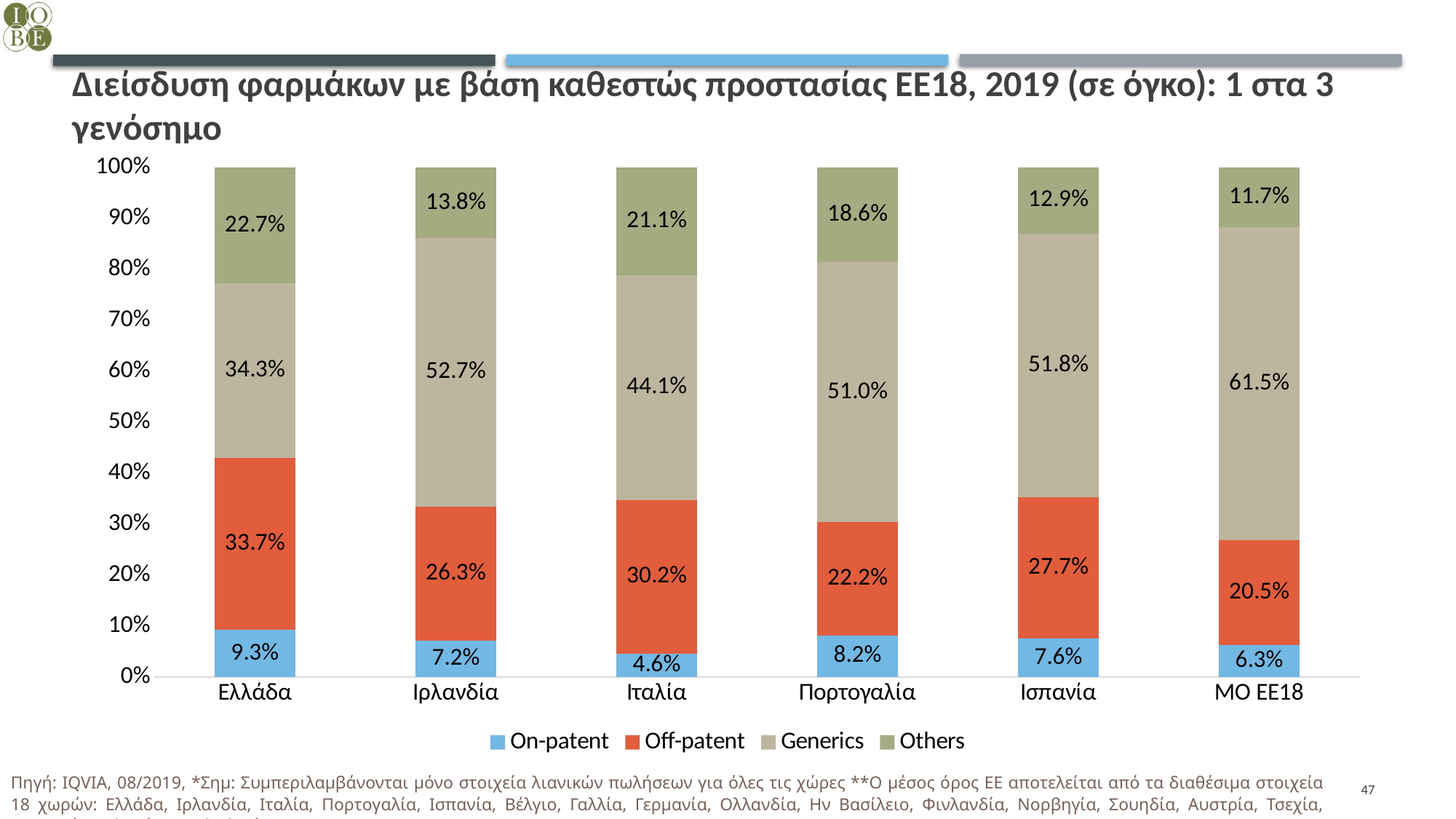
What is the Off-patent share for ΜΟ ΕΕ18? 20.5% How many categories are shown on the x axis? 6 Which is larger: the Others share for Ιρλανδία or for Ιταλία? Ιταλία What kind of chart is shown on the slide? Stacked bar chart What is the difference in Generics share between ΜΟ ΕΕ18 and Ελλάδα? 27.2 percentage points Which category has the highest Generics share? ΜΟ ΕΕ18 What is the Others share for Πορτογαλία? 18.6% Which category has the lowest On-patent share? Ιταλία How many series does the legend list? 4 What is the On-patent share for Ιταλία? 4.6% Which category has the highest Off-patent share? Ελλάδα What is the Generics share for Ελλάδα? 34.3%